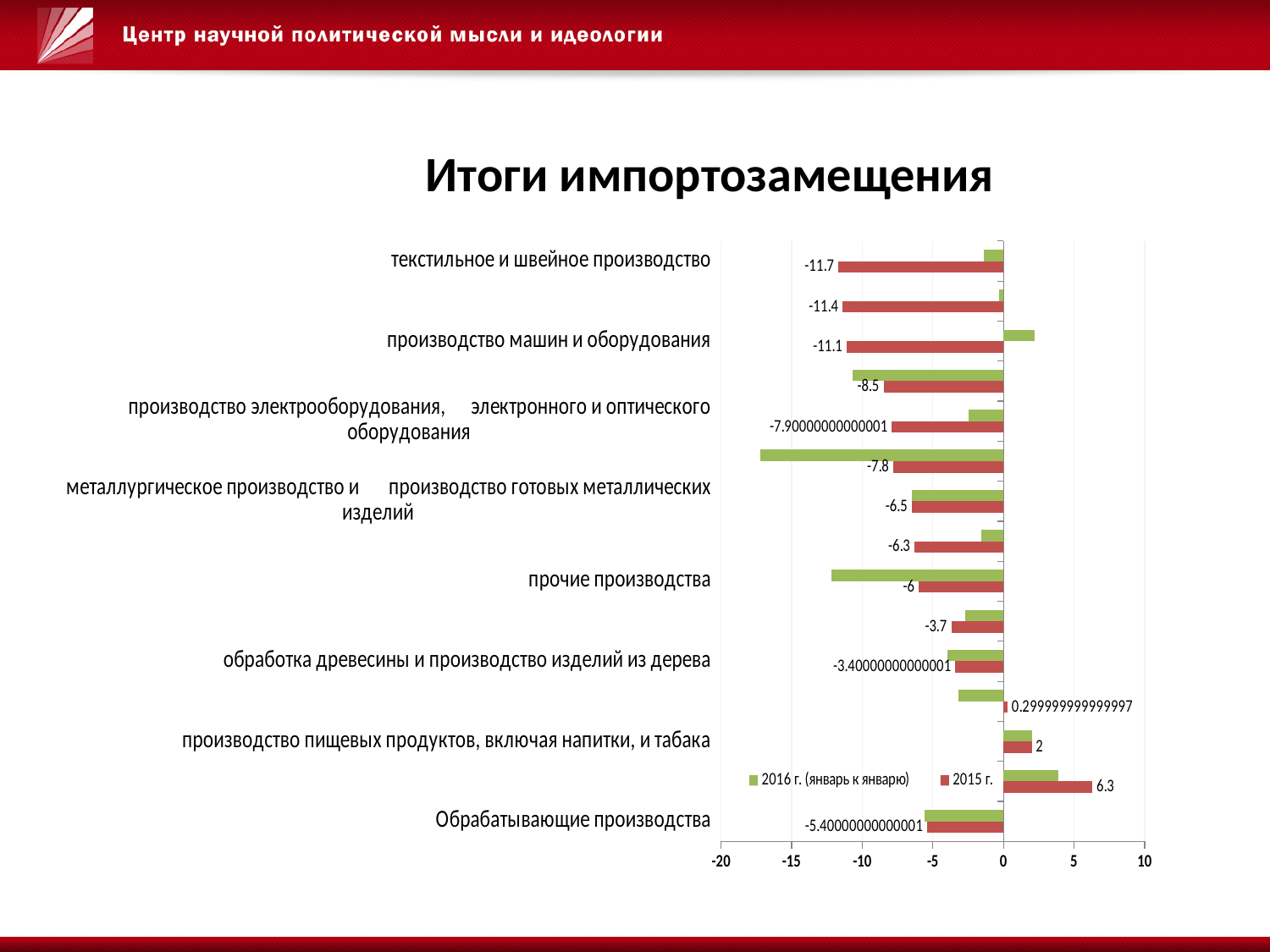
Which labelled category has the lowest 2015 г. value? текстильное и швейное производство What are the two series named in the legend? 2016 г. (январь к январю) and 2015 г. What is the title of the chart? Итоги импортозамещения How many series does the legend list? 2 What is the 2015 г. value for прочие производства? -6 What is the 2015 г. value for производство пищевых продуктов, включая напитки, и табака? 2 What is the 2015 г. value for производство машин и оборудования? -11.1 What is the 2015 г. value for Обрабатывающие производства? -5.40000000000001 Is the 2016 г. (январь к январю) value for прочие производства greater or less than -10? less What is the 2015 г. value for текстильное и швейное производство? -11.7 What kind of chart is shown on the slide? bar chart What is the difference between the 2015 г. values for текстильное и швейное производство and производство машин и оборудования? 0.6